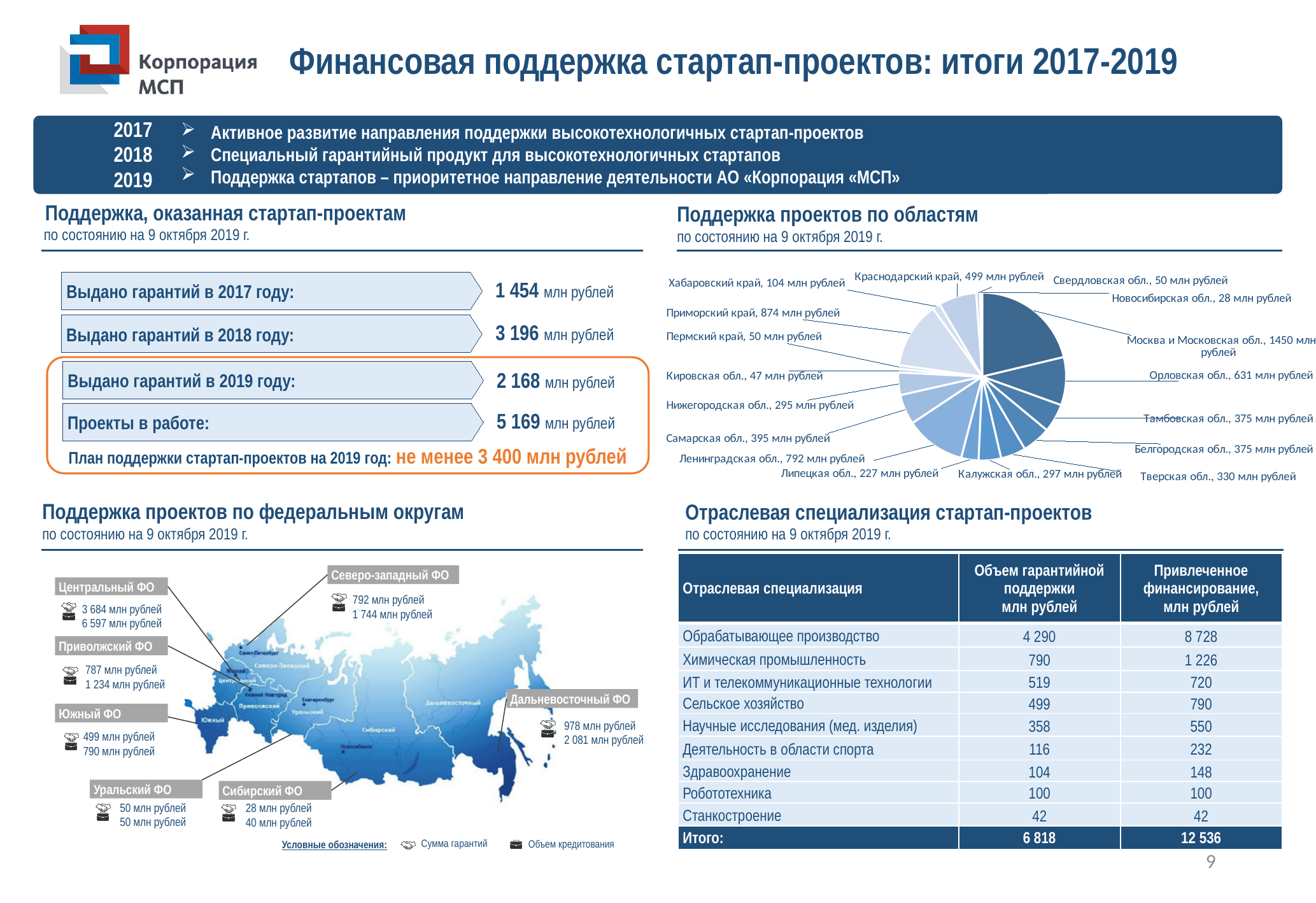
What kind of chart is used in the 'Поддержка проектов по областям' section? pie chart In the pie chart 'Поддержка проектов по областям', which region has the largest value? Москва и Московская обл. In the pie chart 'Поддержка проектов по областям', what is the difference between Приморский край and Ленинградская обл.? 82 млн рублей In the pie chart 'Поддержка проектов по областям', what is the difference between Орловская обл. and Краснодарский край? 132 млн рублей In the pie chart 'Поддержка проектов по областям', which region has the smallest value? Новосибирская обл. In the pie chart 'Поддержка проектов по областям', what is the value for Ленинградская обл.? 792 млн рублей In the pie chart 'Поддержка проектов по областям', which is larger: Самарская обл. or Нижегородская обл.? Самарская обл. How many regions (slices) are shown in the pie chart 'Поддержка проектов по областям'? 17 In the pie chart 'Поддержка проектов по областям', what is the value for Приморский край? 874 млн рублей What is the date stated under the title of the pie chart 'Поддержка проектов по областям'? по состоянию на 9 октября 2019 г. In the pie chart 'Поддержка проектов по областям', what is the value for Москва и Московская обл.? 1450 млн рублей In the pie chart 'Поддержка проектов по областям', what is the value for Кировская обл.? 47 млн рублей